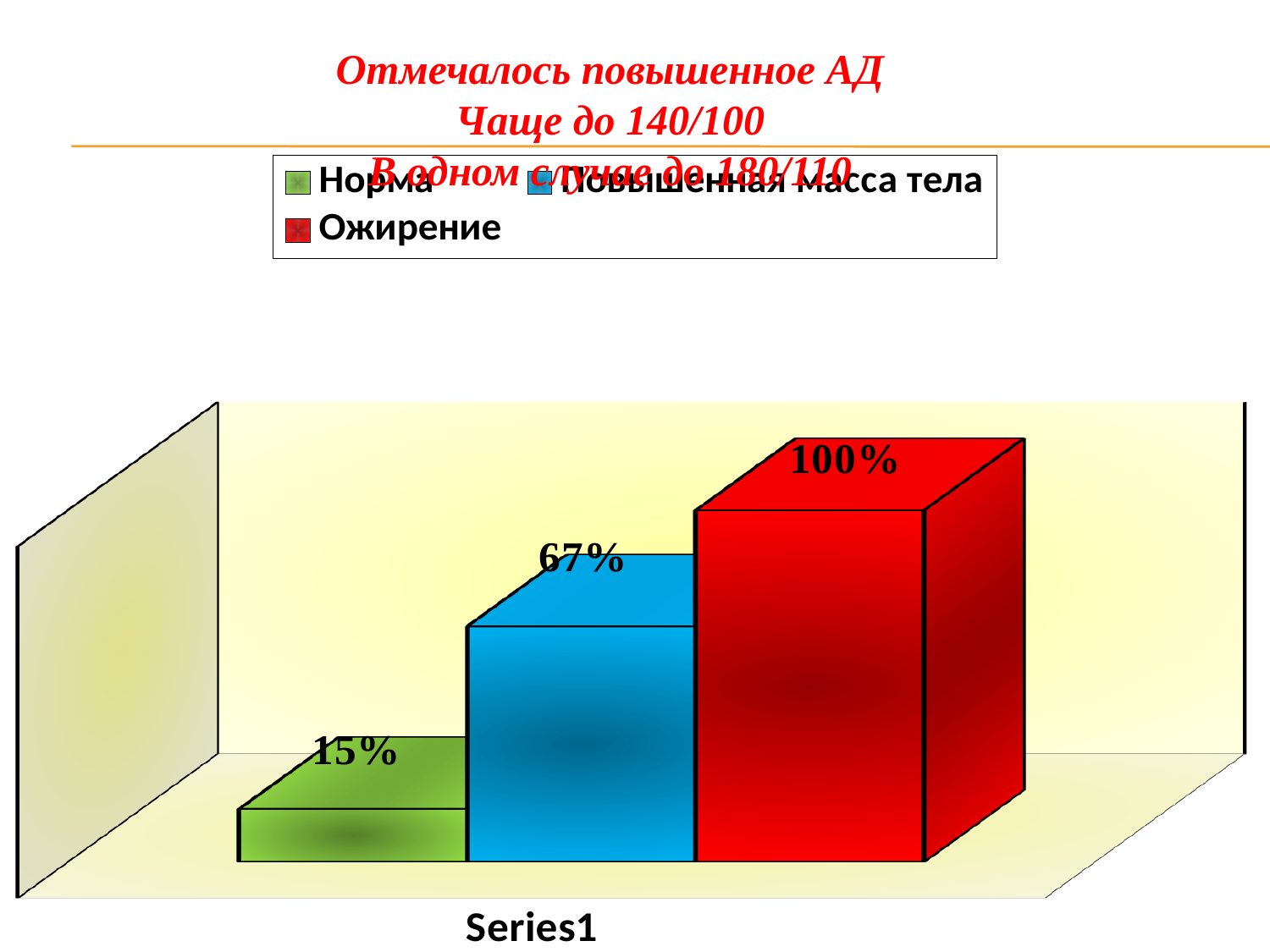
What is the value shown for Норма? 15% Which series has the highest value? Ожирение Which is larger, the value for Норма or the value for Повышенная масса тела? Повышенная масса тела How many series does the legend list? 3 What is the difference between the values for Повышенная масса тела and Норма? 52% Which series has the lowest value? Норма What is the value shown for Повышенная масса тела? 67% What kind of chart is shown on the slide? bar chart What is the value shown for Ожирение? 100% What is the difference between the values for Ожирение and Норма? 85% What is the difference between the values for Ожирение and Повышенная масса тела? 33% What colour is the bar for Ожирение? red